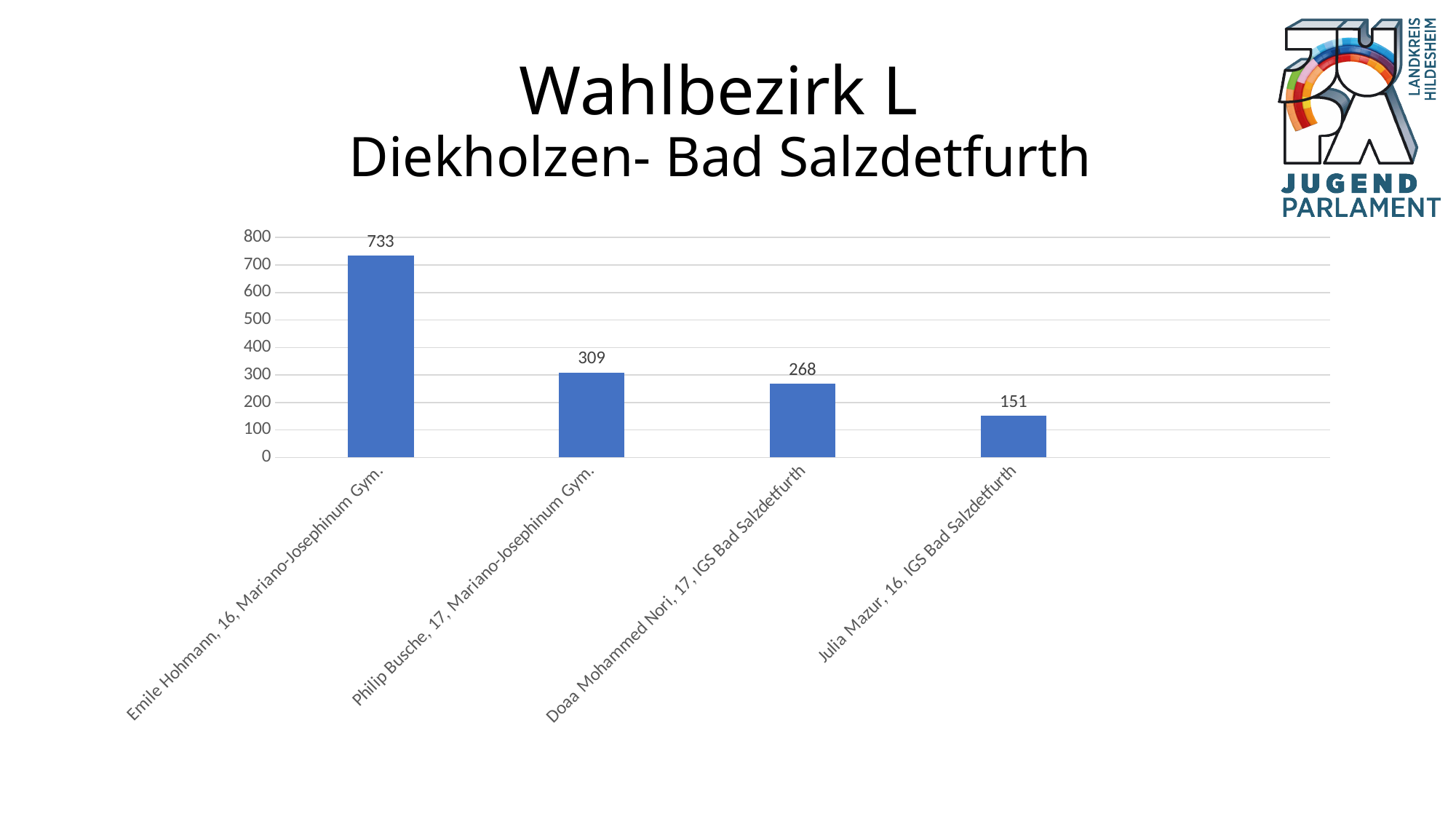
Which candidate has the highest value? Emile Hohmann What is the value shown for Philip Busche? 309 What is the difference between the values for Emile Hohmann and Philip Busche? 424 What kind of chart is shown on the slide? Bar chart What is the value shown for Julia Mazur? 151 Do the values rise or fall from left to right across the chart? Fall What is the difference between the values for Doaa Mohammed Nori and Julia Mazur? 117 How many votes did Emile Hohmann receive? 733 Who has the larger value, Philip Busche or Doaa Mohammed Nori? Philip Busche What is the value shown for Doaa Mohammed Nori? 268 Which candidate has the lowest value? Julia Mazur How many candidates are shown in the chart? 4